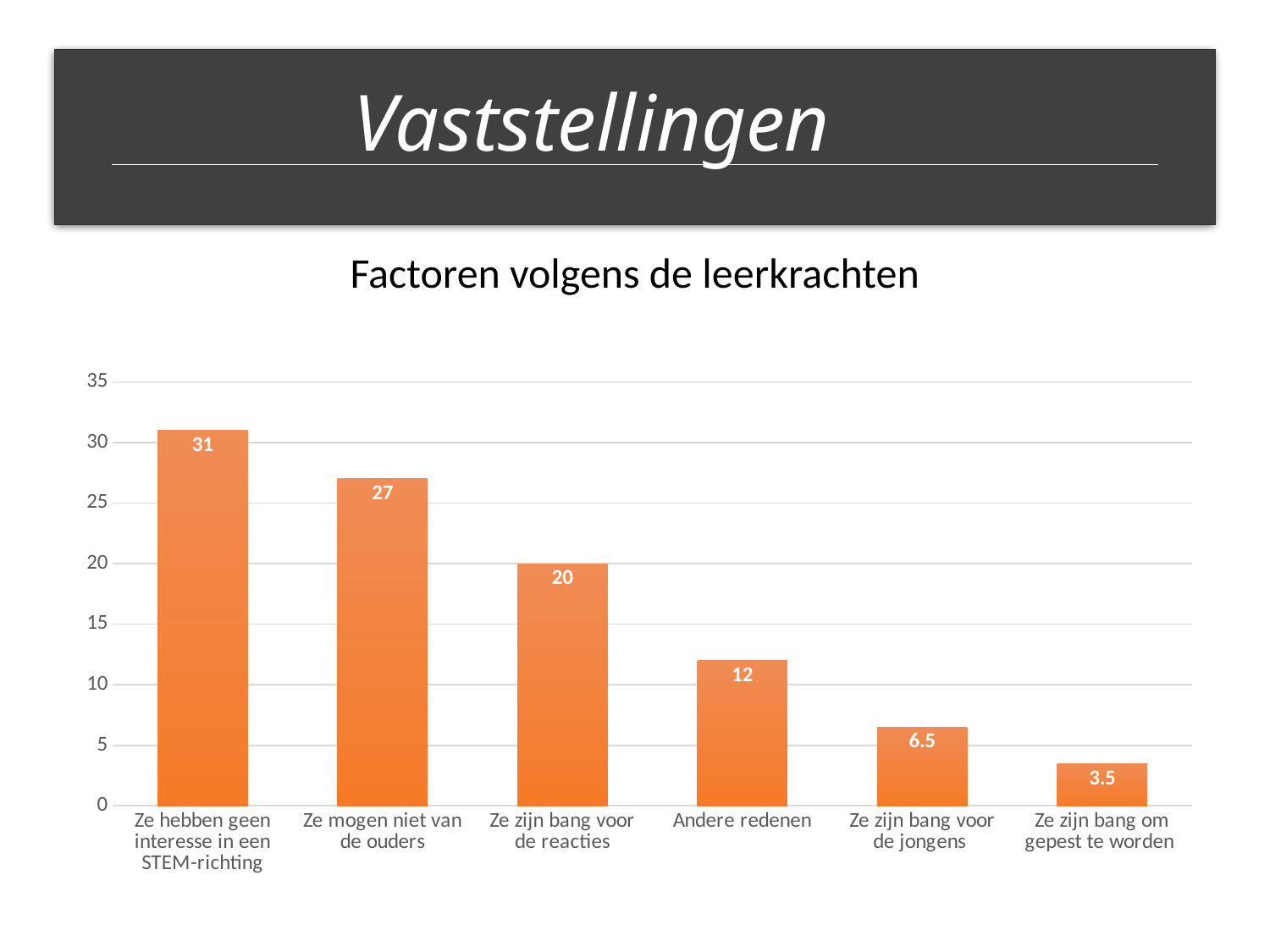
What kind of chart is shown on the slide? bar chart What is the difference between the values for "Ze hebben geen interesse in een STEM-richting" and "Ze zijn bang voor de reacties"? 11 What is the value for "Andere redenen"? 12 What is the value for "Ze mogen niet van de ouders"? 27 What is the value for "Ze zijn bang om gepest te worden"? 3.5 How many categories are shown on the chart? 6 Is the value for "Ze mogen niet van de ouders" greater or less than 25? greater Do the values rise or fall from left to right along the x axis? fall What is the title of the chart? Factoren volgens de leerkrachten Which is larger: the value for "Ze zijn bang voor de jongens" or the value for "Andere redenen"? Andere redenen Which category has the lowest value? Ze zijn bang om gepest te worden Which category has the highest value? Ze hebben geen interesse in een STEM-richting